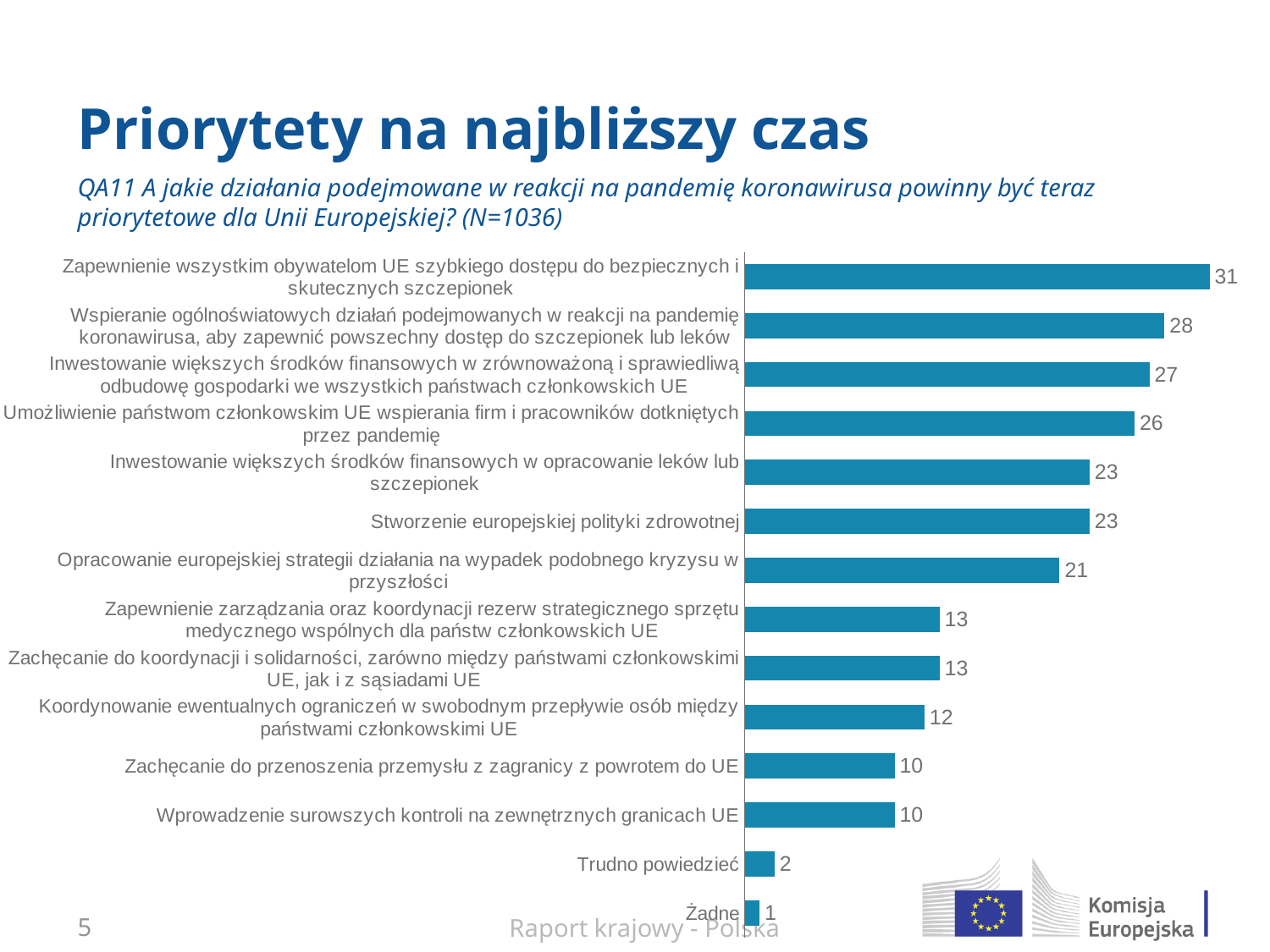
Which category has the lowest value? Żadne What value is shown for "Trudno powiedzieć"? 2 What value is shown for "Inwestowanie większych środków finansowych w zrównoważoną i sprawiedliwą odbudowę gospodarki we wszystkich państwach członkowskich UE"? 27 What is the difference between the value for "Zapewnienie wszystkim obywatelom UE szybkiego dostępu do bezpiecznych i skutecznych szczepionek" and the value for "Wspieranie ogólnoświatowych działań podejmowanych w reakcji na pandemię koronawirusa, aby zapewnić powszechny dostęp do szczepionek lub leków"? 3 Which category has the highest value? Zapewnienie wszystkim obywatelom UE szybkiego dostępu do bezpiecznych i skutecznych szczepionek Which has a larger value: "Umożliwienie państwom członkowskim UE wspierania firm i pracowników dotkniętych przez pandemię" or "Inwestowanie większych środków finansowych w opracowanie leków lub szczepionek"? Umożliwienie państwom członkowskim UE wspierania firm i pracowników dotkniętych przez pandemię What is the difference between the value for "Opracowanie europejskiej strategii działania na wypadek podobnego kryzysu w przyszłości" and the value for "Koordynowanie ewentualnych ograniczeń w swobodnym przepływie osób między państwami członkowskimi UE"? 9 What value is shown for "Stworzenie europejskiej polityki zdrowotnej"? 23 How many categories are shown in the chart? 14 What value is shown for "Zachęcanie do przenoszenia przemysłu z zagranicy z powrotem do UE"? 10 What kind of chart is shown on the slide? Bar chart What is the sample size (N) stated in the question text above the chart? N=1036